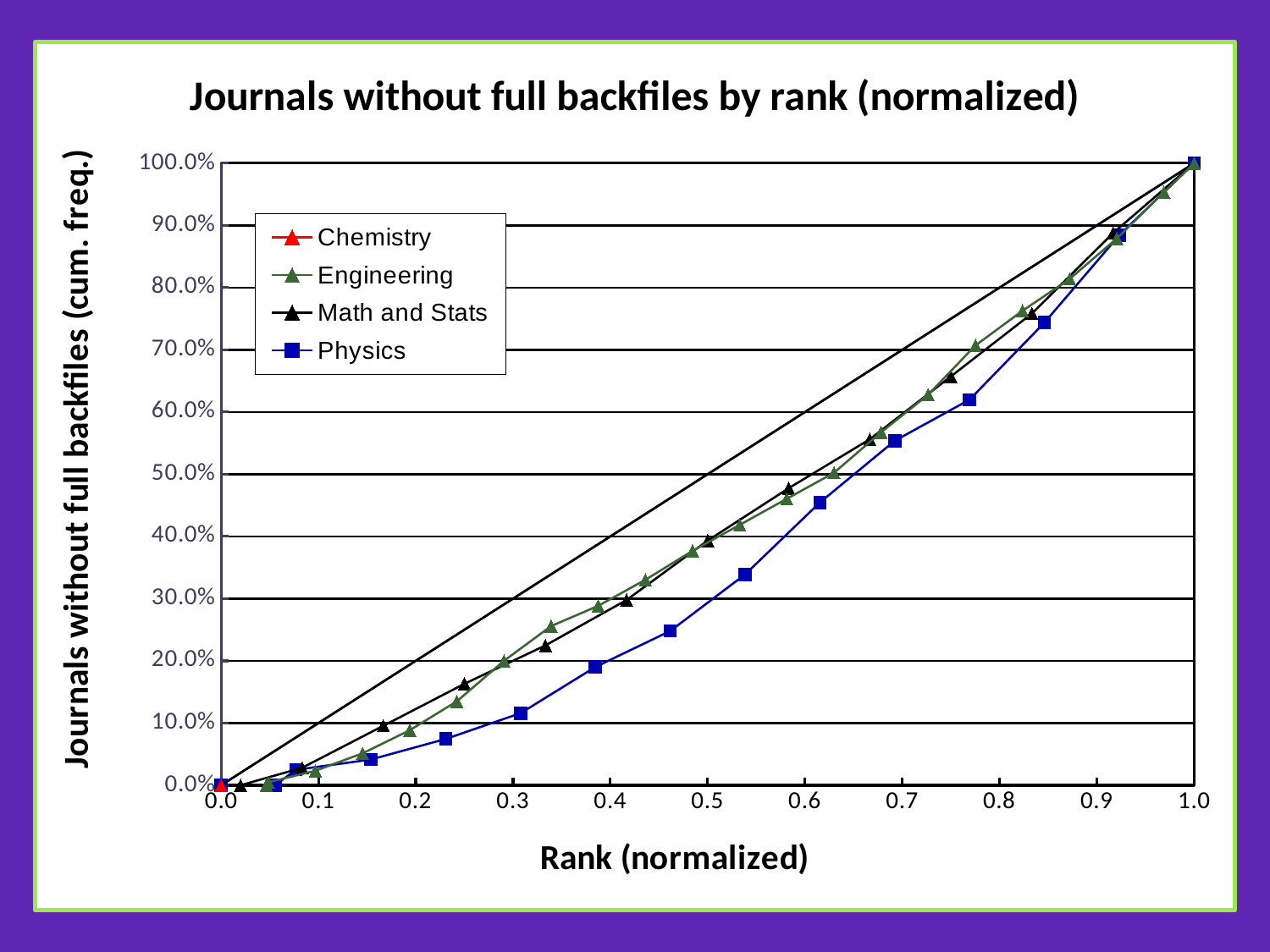
At rank 0.5, which series has the higher value, Engineering or Physics? Engineering Do the values for Physics rise or fall as rank increases along the x axis? rise What kind of chart is shown on the slide? line chart How many series does the legend list? 4 Which series has the lowest value at rank 0.6? Physics At rank 0.4, which series has the higher value, Physics or Math and Stats? Math and Stats Is the value for Physics at rank 0.3 greater or less than 20.0%? less What value does the Physics series reach at rank 1.0? 100.0% What is the title of the chart? Journals without full backfiles by rank (normalized) Is the value for Engineering at rank 0.25 greater or less than 10.0%? greater Is the value for Physics at rank 0.7 greater or less than 50.0%? greater What is the label of the x axis? Rank (normalized)